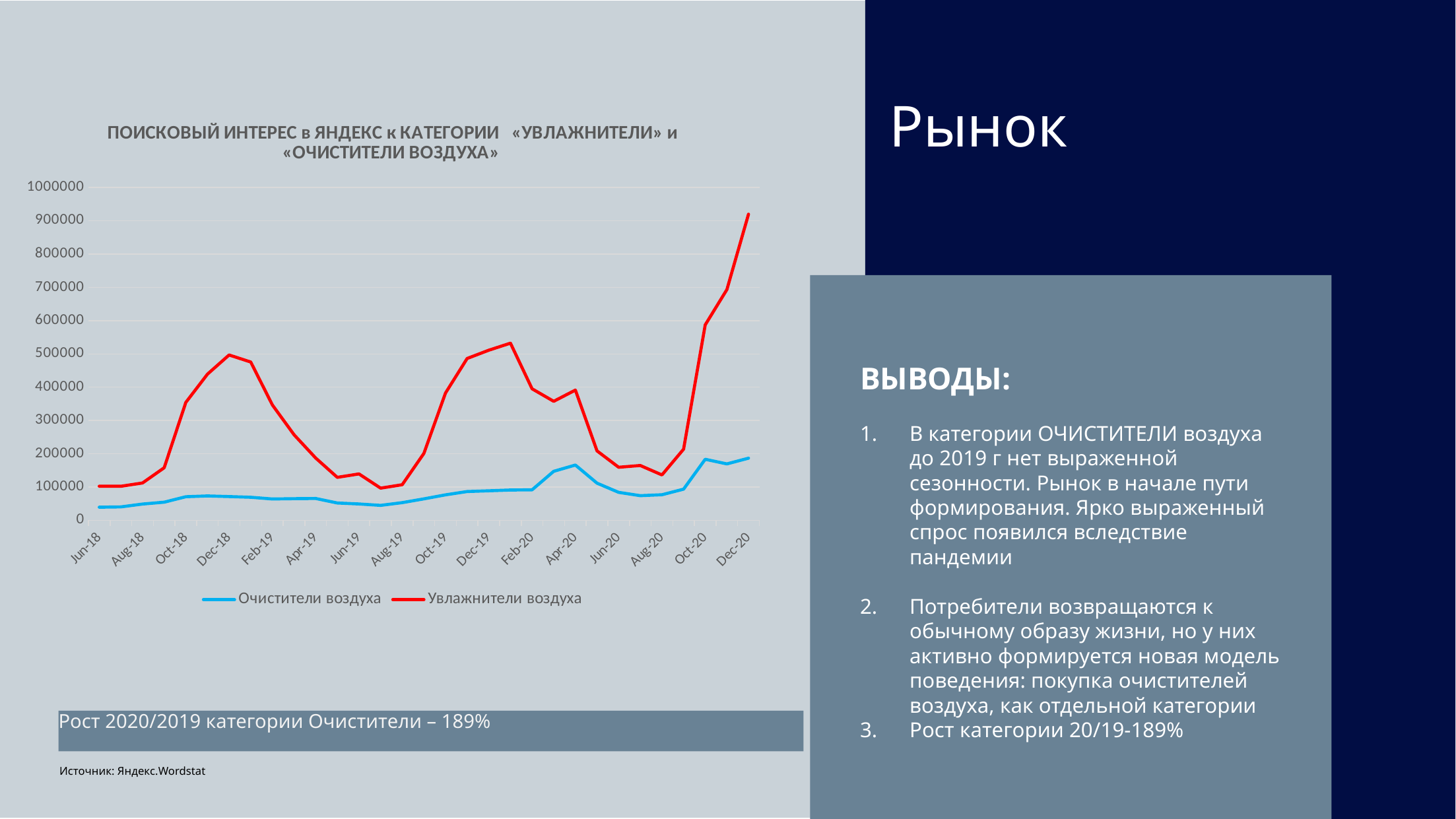
Is the value for Очистители воздуха in Dec-20 greater or less than 100000? greater Does the Увлажнители воздуха series rise or fall from Aug-20 to Dec-20? rise How many series does the chart legend list? 2 Which series is drawn in red in the chart? Увлажнители воздуха What kind of chart is shown on the slide? line chart In Apr-20, which series has the larger value, Очистители воздуха or Увлажнители воздуха? Увлажнители воздуха In which month does the Увлажнители воздуха series reach its highest value? Dec-20 Is the value for Увлажнители воздуха in Dec-20 greater or less than 800000? greater Which series is drawn in blue in the chart? Очистители воздуха Which series reaches the highest value on the chart? Увлажнители воздуха Is the value for Увлажнители воздуха in Dec-19 greater or less than 400000? greater